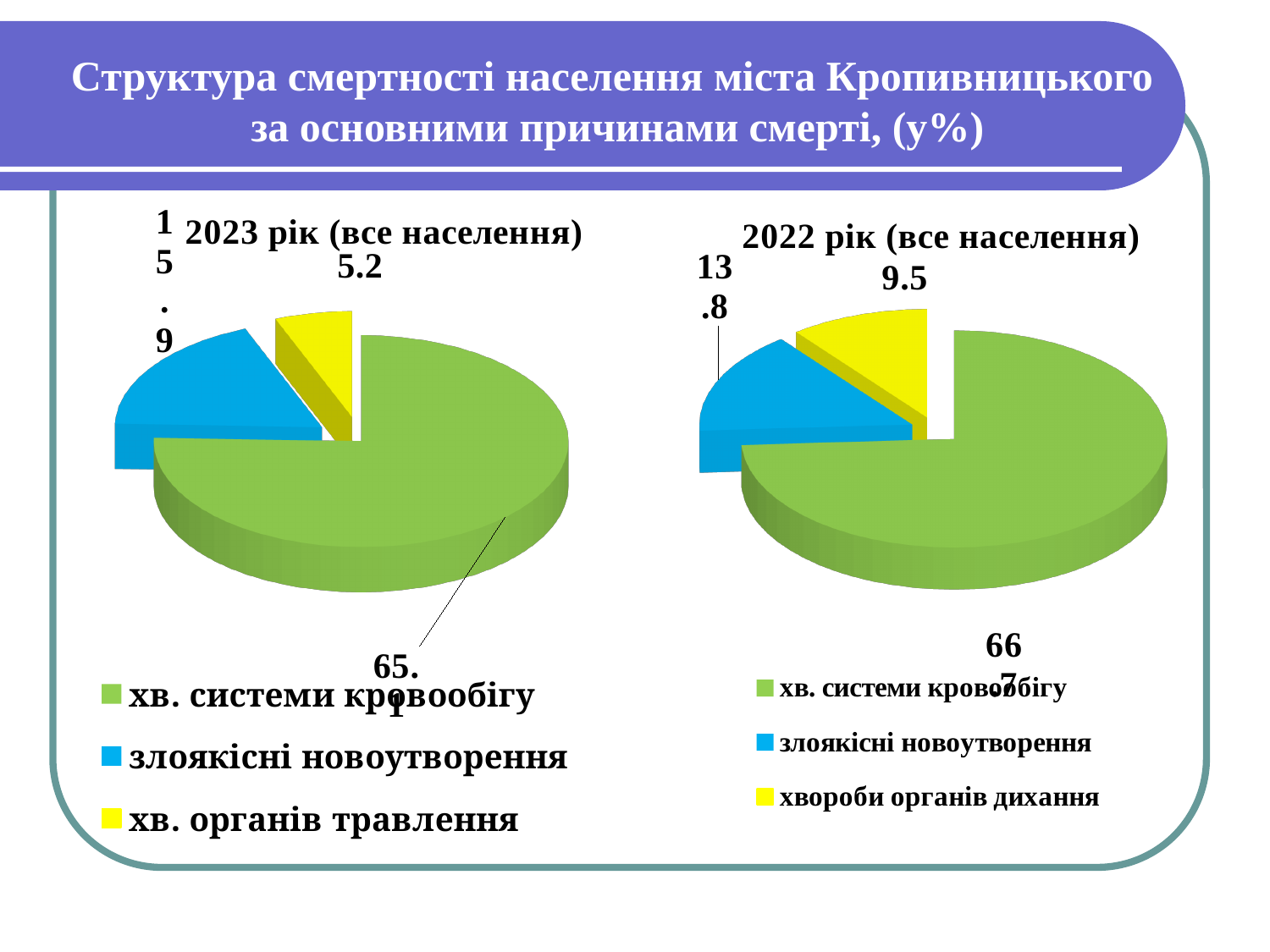
In the 2022 рік (все населення) chart, what is the value for хвороби органів дихання? 9.5 In the 2023 рік (все населення) chart, what is the value for хв. органів травлення? 5.2 What kind of chart is the 2023 рік (все населення) chart? pie chart In the 2022 рік (все населення) chart, what is the difference between злоякісні новоутворення and хвороби органів дихання? 4.3 In the 2023 рік (все населення) chart, what is the value for хв. системи кровообігу? 65.1 In the 2022 рік (все населення) chart, what is the value for злоякісні новоутворення? 13.8 In the 2022 рік (все населення) chart, which category has the largest slice? хв. системи кровообігу In the 2023 рік (все населення) chart, what is the value for злоякісні новоутворення? 15.9 In the 2023 рік (все населення) chart, which is larger: злоякісні новоутворення or хв. органів травлення? злоякісні новоутворення What colour is the хв. системи кровообігу slice in the 2023 рік (все населення) chart? green How many slices does the 2022 рік (все населення) pie chart have? 3 In the 2023 рік (все населення) chart, which category has the smallest slice? хв. органів травлення